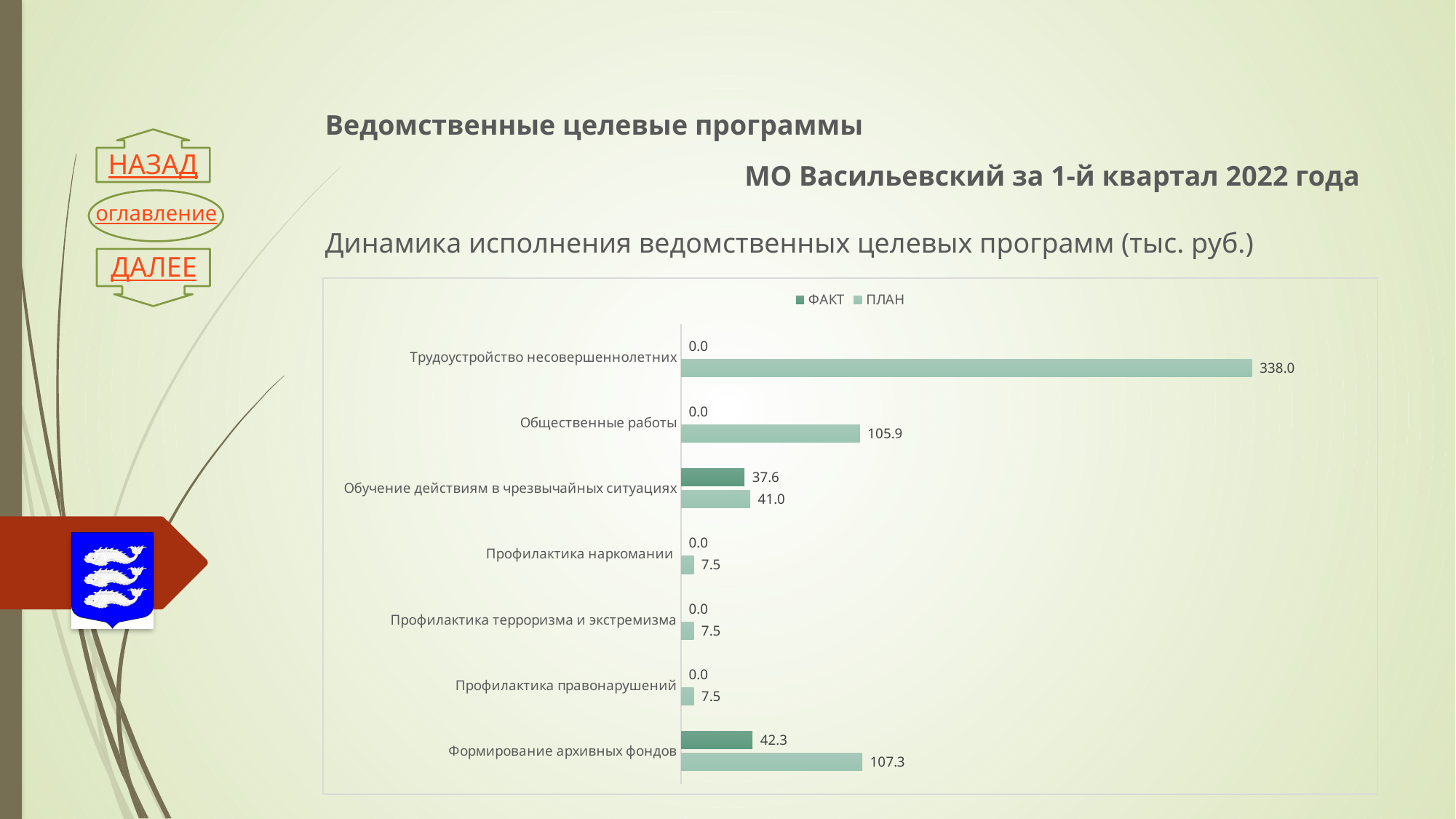
What is the ПЛАН value for Трудоустройство несовершеннолетних? 338.0 How many series does the legend list? 2 What is the difference between the ПЛАН and ФАКТ values for Обучение действиям в чрезвычайных ситуациях? 3.4 What kind of chart is shown on the slide? Bar chart What is the difference between the ПЛАН and ФАКТ values for Формирование архивных фондов? 65.0 What is the ФАКТ value for Формирование архивных фондов? 42.3 How many categories are shown on the chart? 7 What is the ПЛАН value for Общественные работы? 105.9 Which category has the highest ПЛАН value? Трудоустройство несовершеннолетних Which category has the highest ФАКТ value? Формирование архивных фондов Which is larger: the ПЛАН value for Общественные работы or the ПЛАН value for Формирование архивных фондов? Формирование архивных фондов What is the ФАКТ value for Обучение действиям в чрезвычайных ситуациях? 37.6